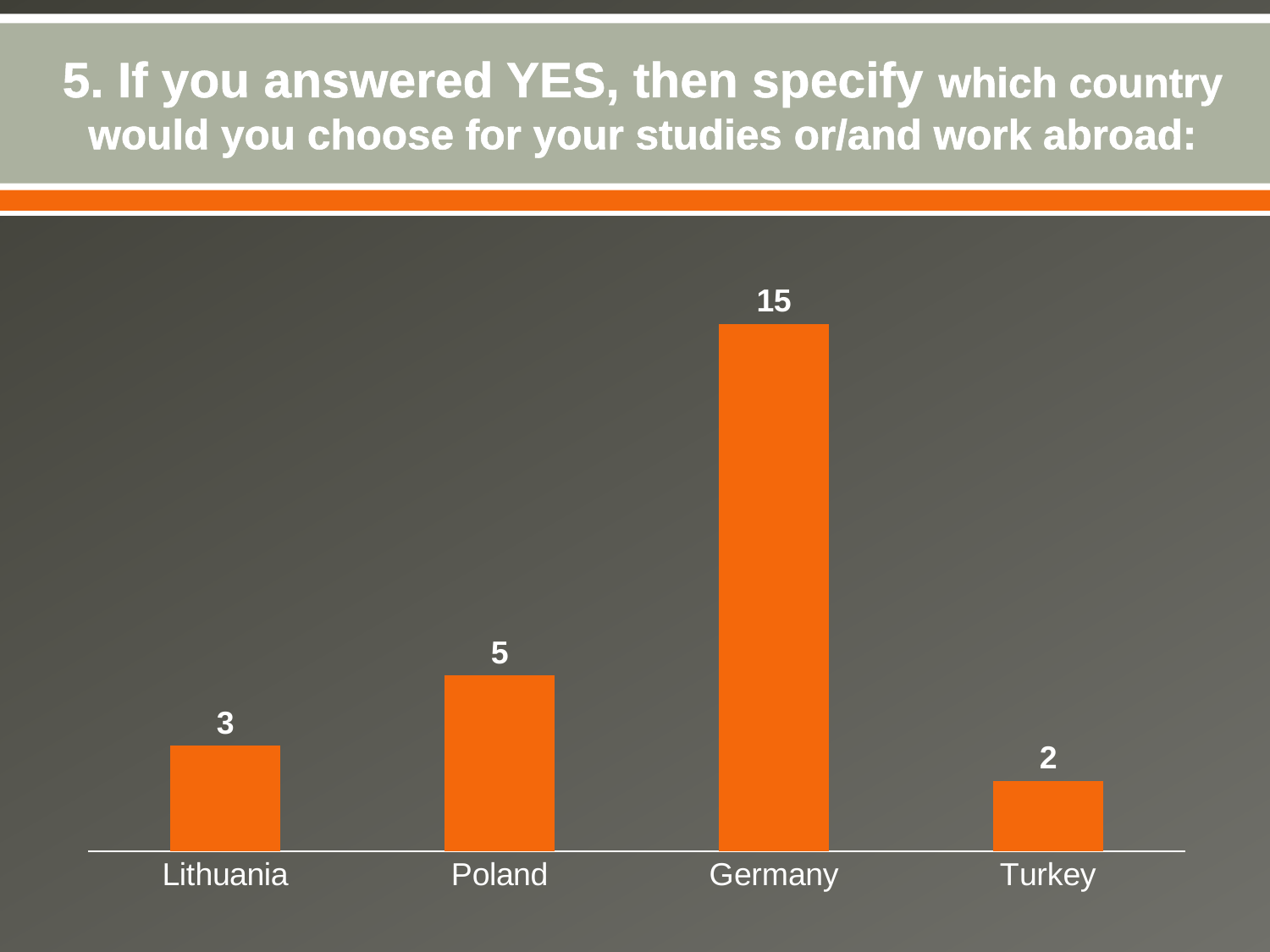
How many countries are shown in the chart? 4 Which country has the lowest value? Turkey What is the value for Turkey? 2 What is the value for Poland? 5 What is the value for Germany? 15 What kind of chart is shown on the slide? Bar chart What is the value for Lithuania? 3 Which is larger, the value for Poland or the value for Lithuania? Poland What is the difference between the values for Germany and Poland? 10 What colour are the bars in the chart? Orange Which country has the highest value? Germany What is the difference between the values for Lithuania and Turkey? 1